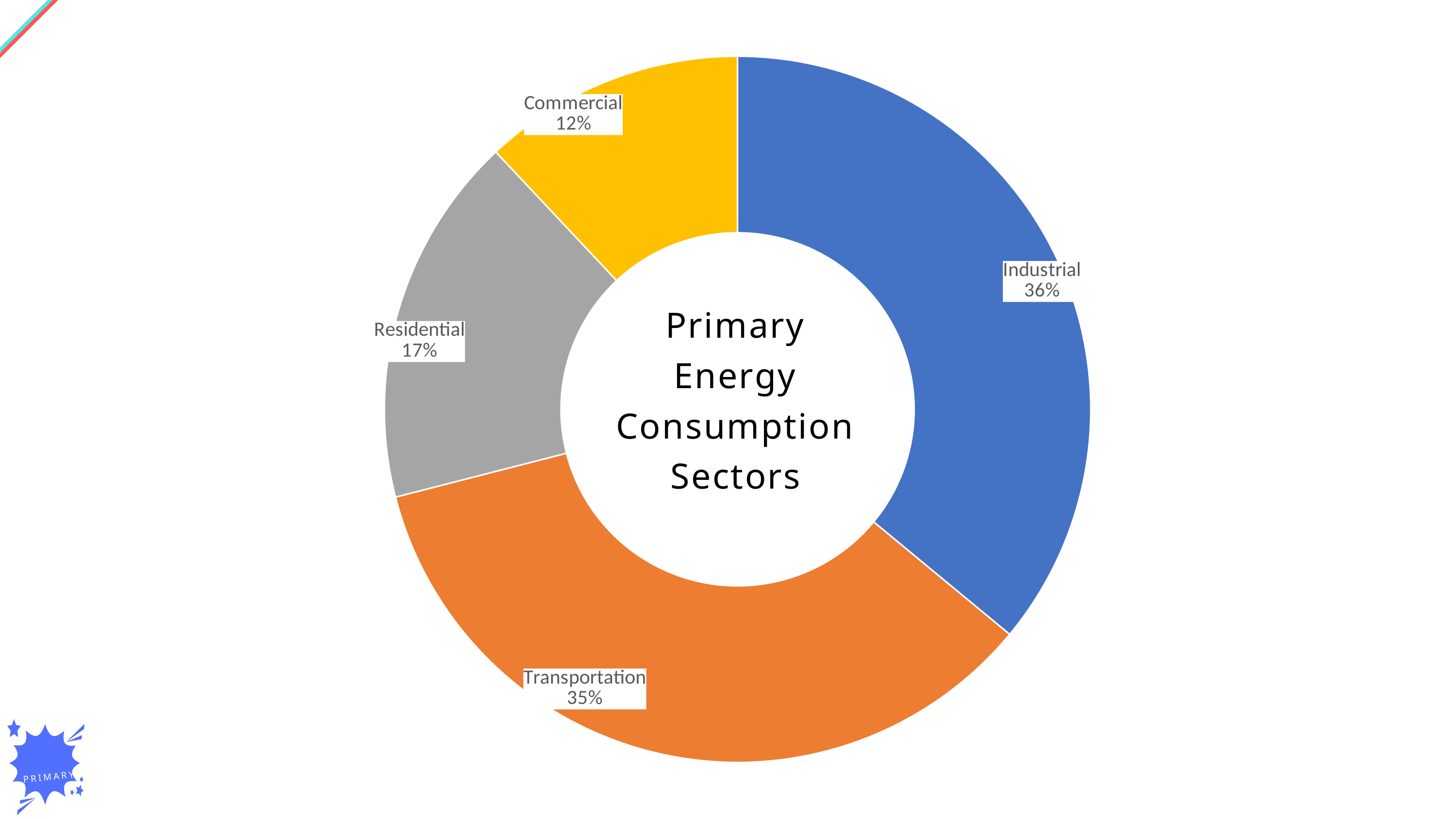
What type of chart is shown on the slide? Doughnut (pie) chart What is the value shown for the Residential sector? 17% How many sectors are shown in the chart? 4 Which is larger, the Residential share or the Commercial share? Residential What percentage is shown for the Transportation sector? 35% What share of primary energy consumption does the Industrial sector account for? 36% What is the difference in percentage points between the Industrial and Commercial sectors? 24 What is the difference in percentage points between the Residential and Commercial sectors? 5 What percentage is shown for the Commercial sector? 12% What is the title shown in the centre of the chart? Primary Energy Consumption Sectors Which sector has the smallest share of the chart? Commercial Which is larger, the Transportation share or the Residential share? Transportation